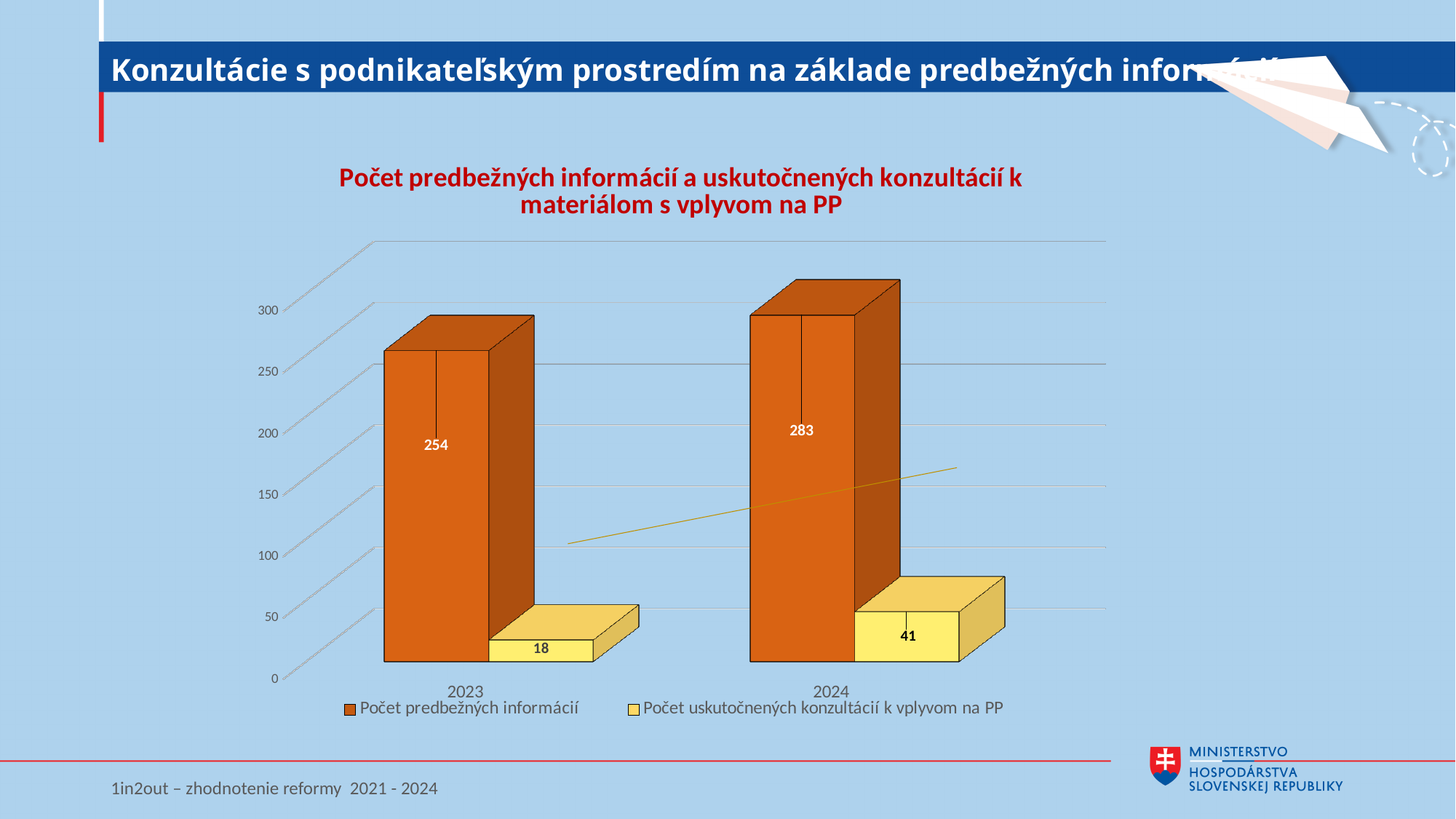
Which year has the higher value for "Počet predbežných informácií"? 2024 What is the value of "Počet predbežných informácií" for 2023? 254 Do the values of "Počet uskutočnených konzultácií k vplyvom na PP" rise or fall from 2023 to 2024? Rise How many series does the legend list? 2 What is the difference between "Počet uskutočnených konzultácií k vplyvom na PP" in 2024 and in 2023? 23 What is the value of "Počet uskutočnených konzultácií k vplyvom na PP" for 2023? 18 What is the value of "Počet uskutočnených konzultácií k vplyvom na PP" for 2024? 41 What kind of chart is shown on the slide? Bar chart Which year has the lower value for "Počet uskutočnených konzultácií k vplyvom na PP"? 2023 How many years are shown on the x axis? 2 What is the value of "Počet predbežných informácií" for 2024? 283 By how much did "Počet predbežných informácií" increase from 2023 to 2024? 29